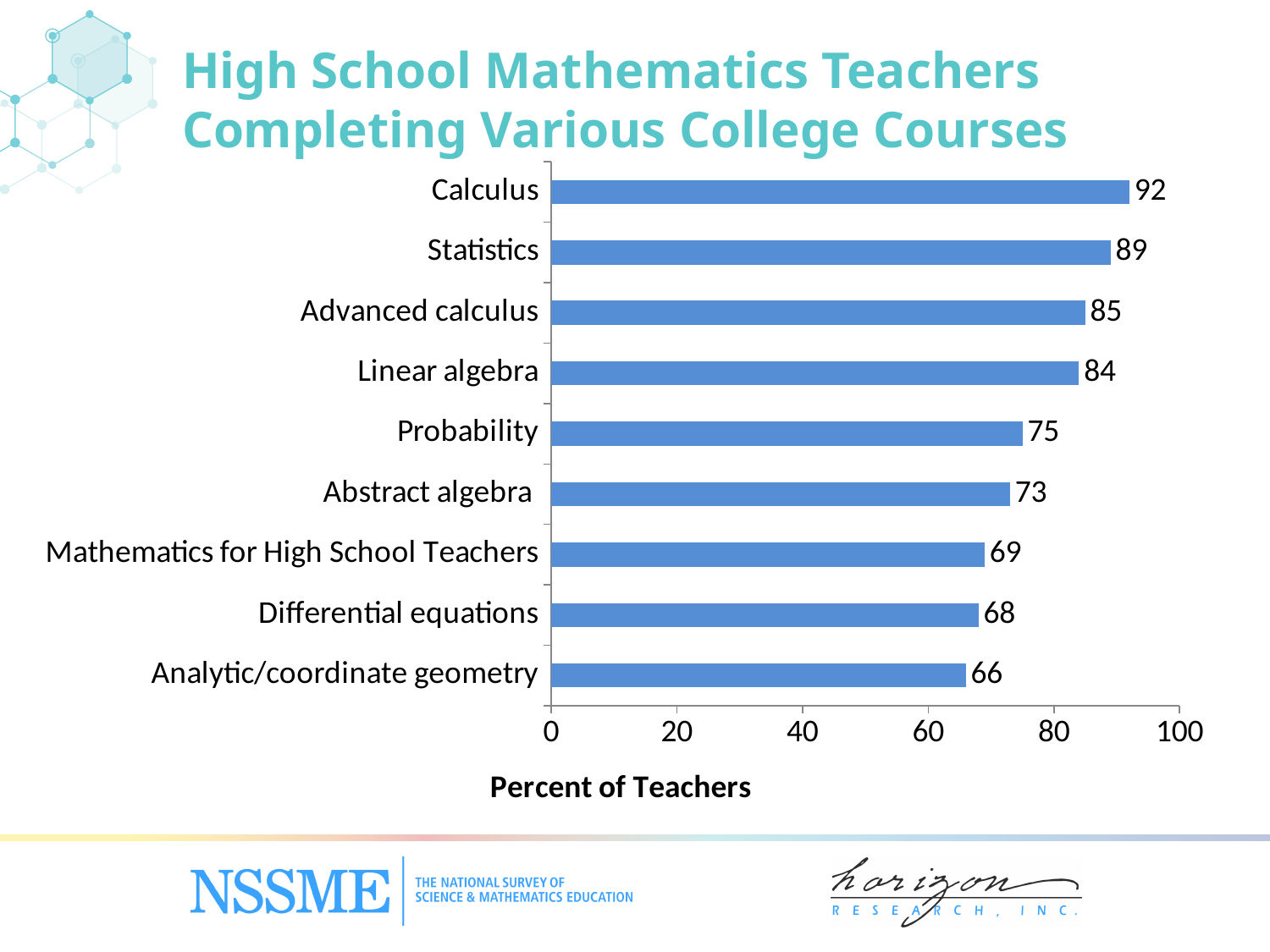
Which course has the highest percent of teachers? Calculus What is the difference between the values for Linear algebra and Abstract algebra? 11 What percent of teachers completed Differential equations? 68 What is the difference between the values for Calculus and Statistics? 3 How many courses are shown in the chart? 9 What is the value for Probability? 75 Which course has the lowest percent of teachers? Analytic/coordinate geometry What percent of teachers completed Calculus? 92 What is the label of the horizontal axis? Percent of Teachers Which is larger, the value for Advanced calculus or the value for Mathematics for High School Teachers? Advanced calculus What kind of chart is shown on the slide? bar chart Is the value for Abstract algebra greater or less than 80? less